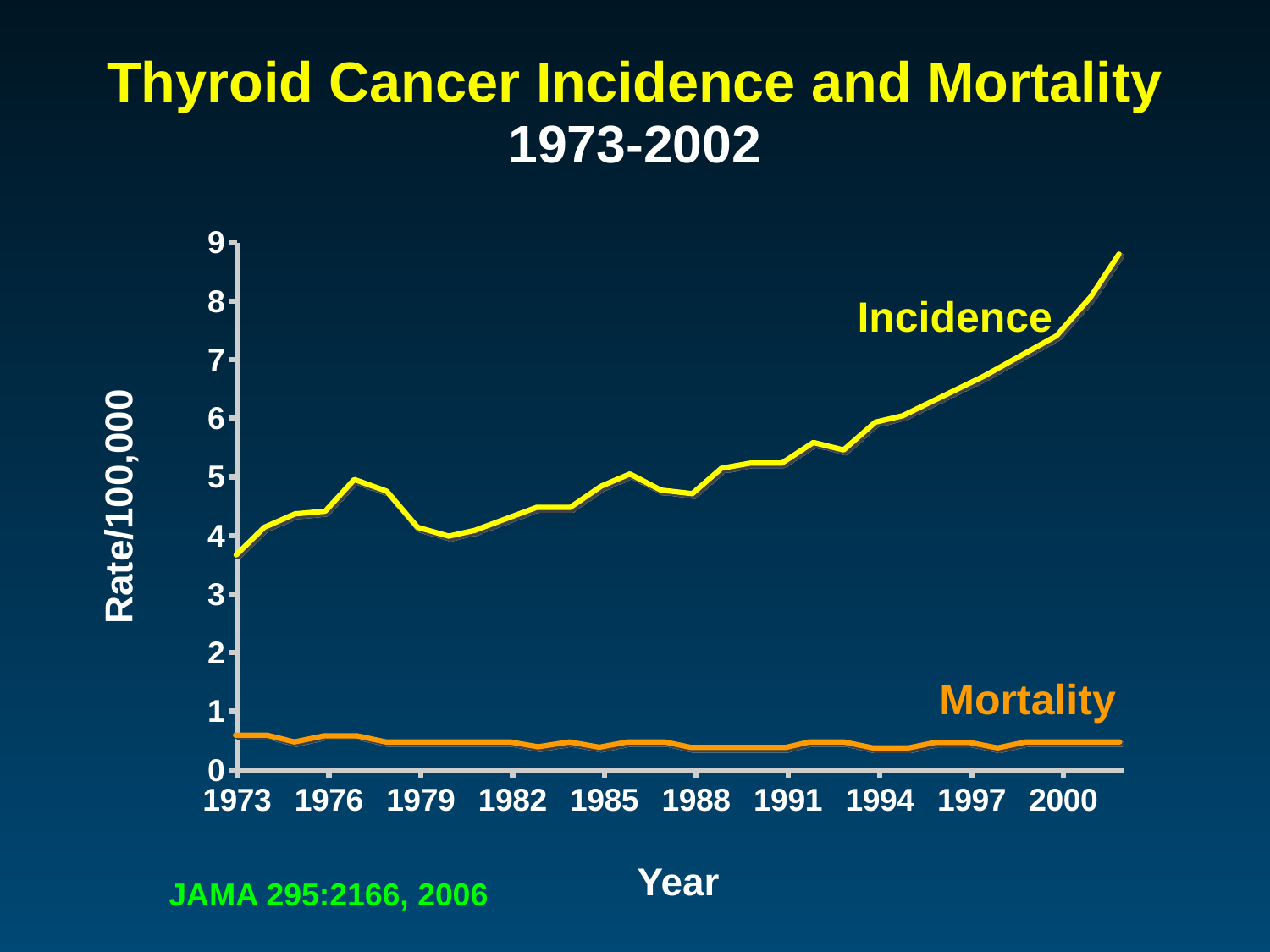
Which series stays nearly flat across the whole period? Mortality How many series are plotted on the chart? 2 Is the Incidence value in 1973 greater or less than 4? less What are the names of the two series plotted on the chart? Incidence and Mortality Is the Incidence value in 1994 greater or less than 5? greater What is the title of the chart? Thyroid Cancer Incidence and Mortality 1973-2002 What kind of chart is shown on the slide? line chart Which series has the higher value in 2000, Incidence or Mortality? Incidence Is the Incidence value at the end of the series (2002) greater or less than 8? greater How many year labels are shown on the x axis? 10 Does the Incidence line generally rise or fall from 1973 to 2002? rise